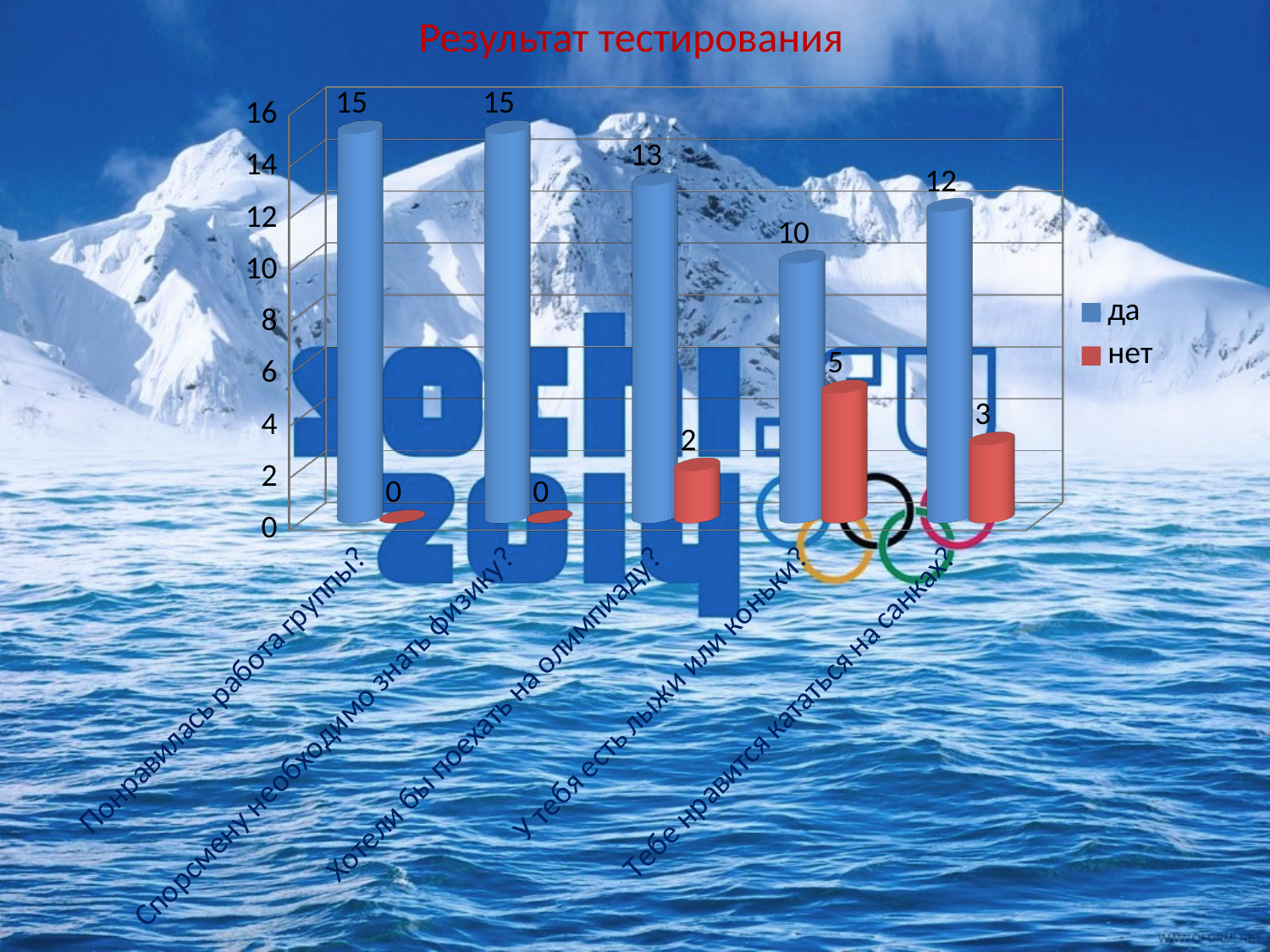
How many series does the legend list? 2 What is the value for "нет" for the question "У тебя есть лыжи или коньки?"? 5 How many questions (categories) are shown on the x axis of the chart? 5 What is the value for "нет" for the question "Понравилась работа группы?"? 0 Which question has the lowest value for "да"? У тебя есть лыжи или коньки? What is the value for "да" for the question "Хотели бы поехать на олимпиаду?"? 13 What is the value for "да" for the question "Тебе нравится кататься на санках?"? 12 What is the title of the chart? Результат тестирования Which question has the highest value for "нет"? У тебя есть лыжи или коньки? What is the difference between the "да" and "нет" values for "Тебе нравится кататься на санках?"? 9 What kind of chart is shown on the slide? bar chart For "Хотели бы поехать на олимпиаду?", which is larger, the "да" value or the "нет" value? да